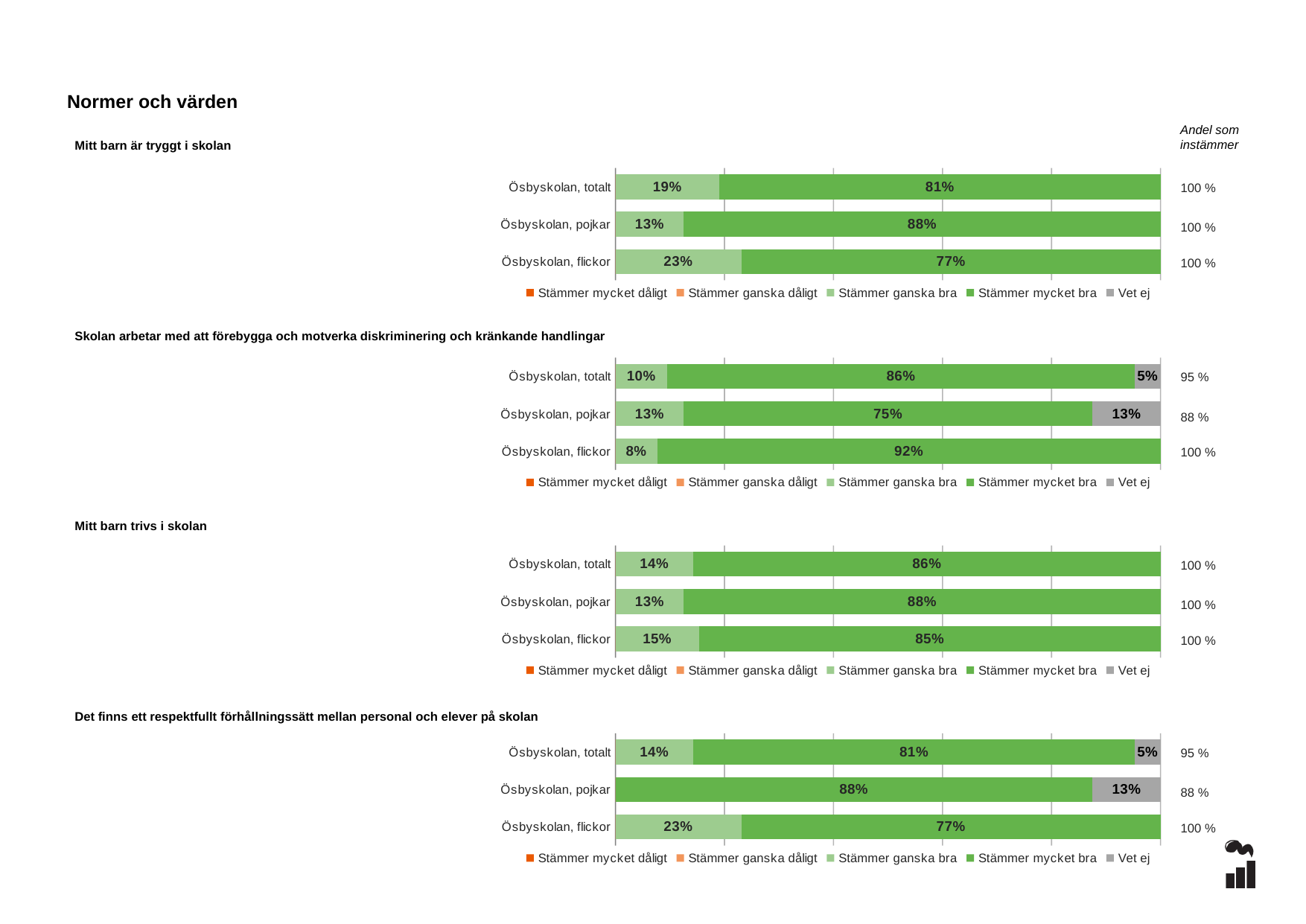
What kind of chart is 'Mitt barn är tryggt i skolan'? Stacked bar chart In the chart 'Mitt barn är tryggt i skolan', what is the value of 'Stämmer mycket bra' for Ösbyskolan, pojkar? 88% In the chart 'Skolan arbetar med att förebygga och motverka diskriminering och kränkande handlingar', what is the difference between the 'Stämmer mycket bra' values for Ösbyskolan, flickor and Ösbyskolan, pojkar? 17% In the chart 'Det finns ett respektfullt förhållningssätt mellan personal och elever på skolan', what is the 'Andel som instämmer' value for Ösbyskolan, pojkar? 88 % How many categories are shown in the chart 'Mitt barn trivs i skolan'? 3 How many series does the legend of the chart 'Mitt barn är tryggt i skolan' list? 5 In the chart 'Det finns ett respektfullt förhållningssätt mellan personal och elever på skolan', what is the 'Stämmer mycket bra' value for Ösbyskolan, flickor? 77% In the chart 'Mitt barn trivs i skolan', what is the 'Stämmer ganska bra' value for Ösbyskolan, totalt? 14% In the chart 'Mitt barn är tryggt i skolan', which category has the highest 'Stämmer ganska bra' value? Ösbyskolan, flickor In the chart 'Skolan arbetar med att förebygga och motverka diskriminering och kränkande handlingar', which category has the lowest 'Stämmer mycket bra' value? Ösbyskolan, pojkar In the chart 'Mitt barn trivs i skolan', which is larger: the 'Stämmer mycket bra' value for Ösbyskolan, pojkar or for Ösbyskolan, flickor? Ösbyskolan, pojkar In the chart 'Skolan arbetar med att förebygga och motverka diskriminering och kränkande handlingar', what is the 'Vet ej' value for Ösbyskolan, pojkar? 13%